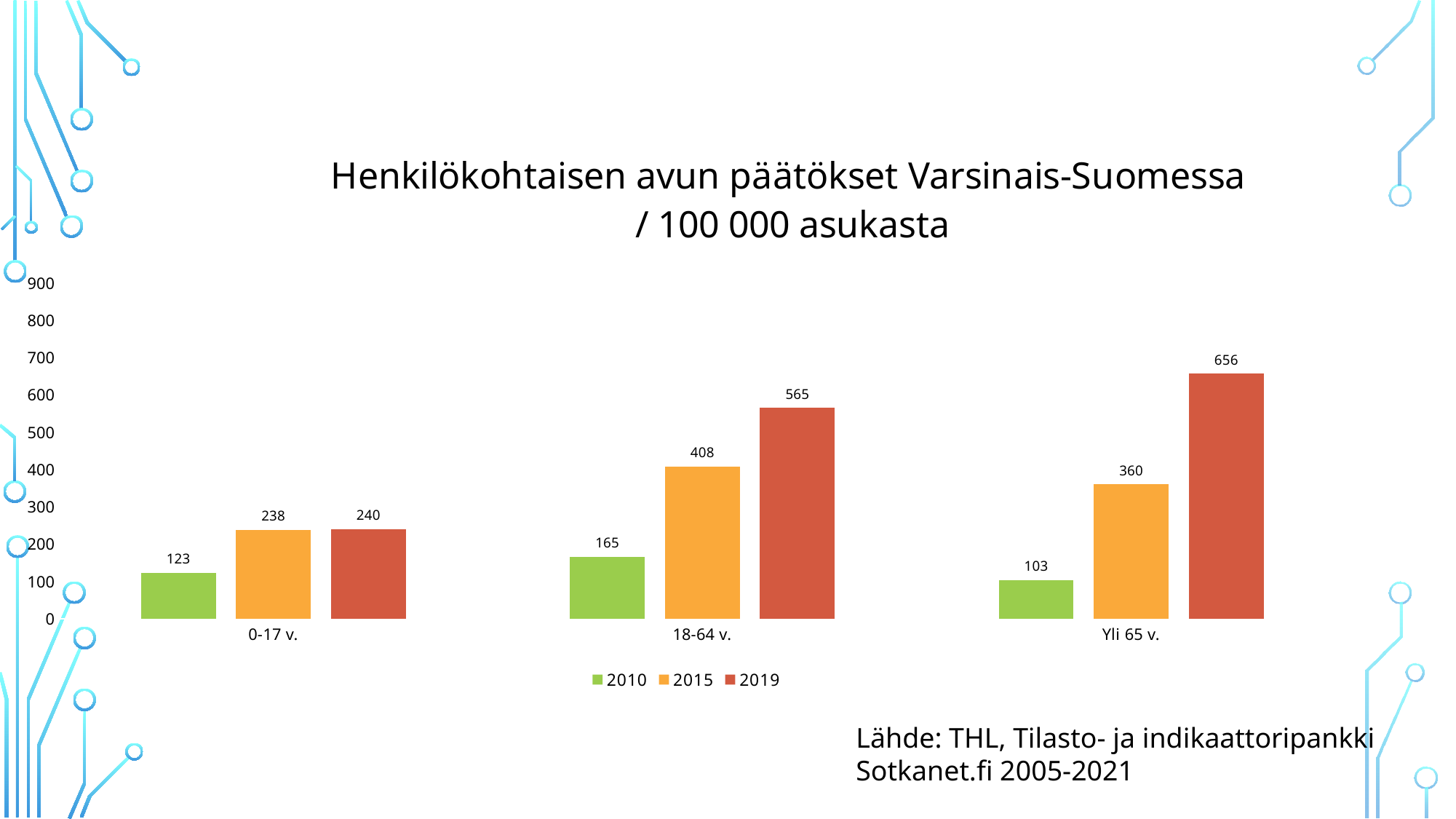
Which category has the highest value for 2019? Yli 65 v. What kind of chart is shown on the slide? bar chart What is the value for 2015 in the 18-64 v. category? 408 What is the difference between the 2019 and 2010 values in the 18-64 v. category? 400 Which is larger: the 2015 value for 18-64 v. or the 2015 value for Yli 65 v.? 18-64 v. How many series does the legend list? 3 Which year does the legend associate with the green bars? 2010 What is the value for 2010 in the 0-17 v. category? 123 Which category has the lowest value for 2010? Yli 65 v. How many age categories are shown on the x axis? 3 Is the value for 2019 in the 18-64 v. category greater or less than 500? greater What is the value for 2019 in the Yli 65 v. category? 656